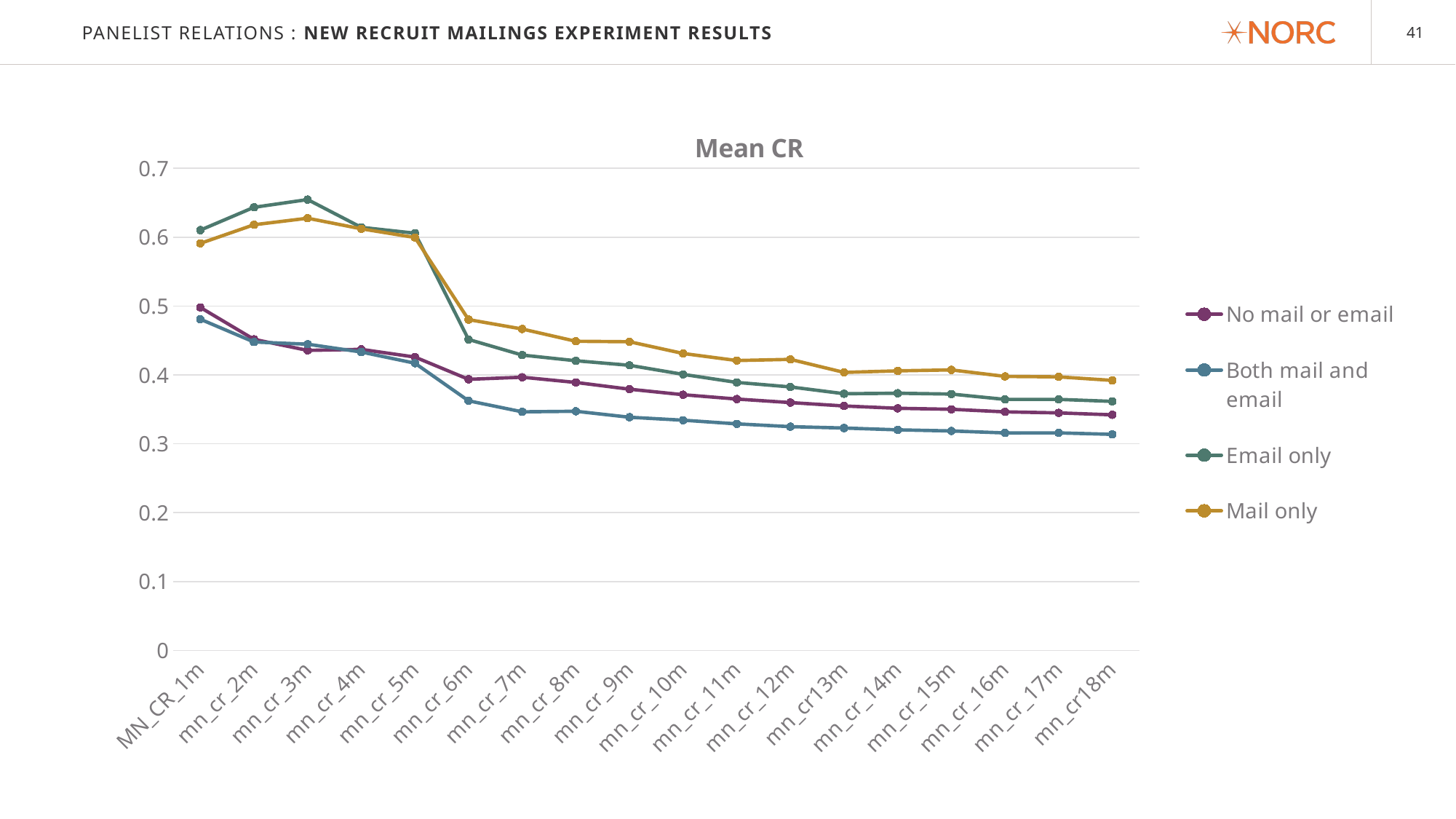
At mn_cr18m, which is larger: No mail or email or Both mail and email? No mail or email Is the value for Mail only at mn_cr_6m greater or less than 0.5? less How many categories are plotted along the x axis? 18 What is the title of the chart? Mean CR Which series has the lowest value at mn_cr_7m? Both mail and email Which series has the highest value at mn_cr_10m? Mail only At mn_cr_3m, which is larger: Email only or Mail only? Email only Is the value for Both mail and email at mn_cr18m greater or less than 0.4? less How many series does the legend list? 4 Do the values for Both mail and email rise or fall from mn_cr_6m to mn_cr18m? fall Is the value for Email only at mn_cr_3m greater or less than 0.6? greater What kind of chart is shown on the slide? line chart